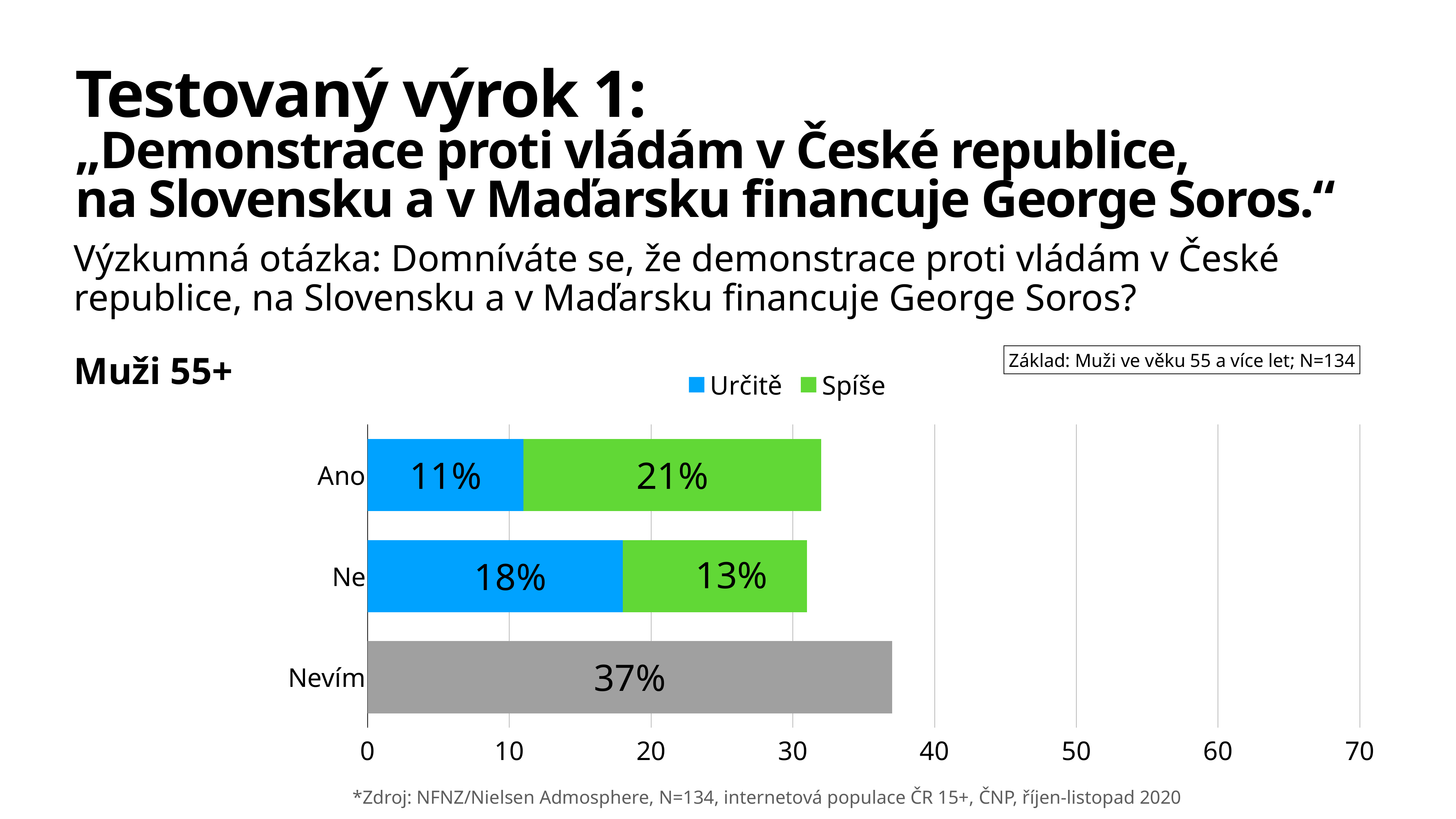
What kind of chart is shown on the slide? Stacked bar chart What is the 'Spíše' value for the 'Ne' category? 13% Which is larger: the 'Spíše' value for 'Ano' or the 'Spíše' value for 'Ne'? Ano Which category has the longest bar overall? Nevím What is the total of the stacked bar for 'Ano'? 32% What is the difference between the 'Určitě' values for 'Ne' and 'Ano'? 7% What is the total of the stacked bar for 'Ne'? 31% How many series does the legend list? 2 How many categories are shown on the chart? 3 What is the 'Určitě' value for the 'Ano' category? 11% What is the 'Spíše' value for the 'Ano' category? 21% What is the value shown for the 'Nevím' category? 37%